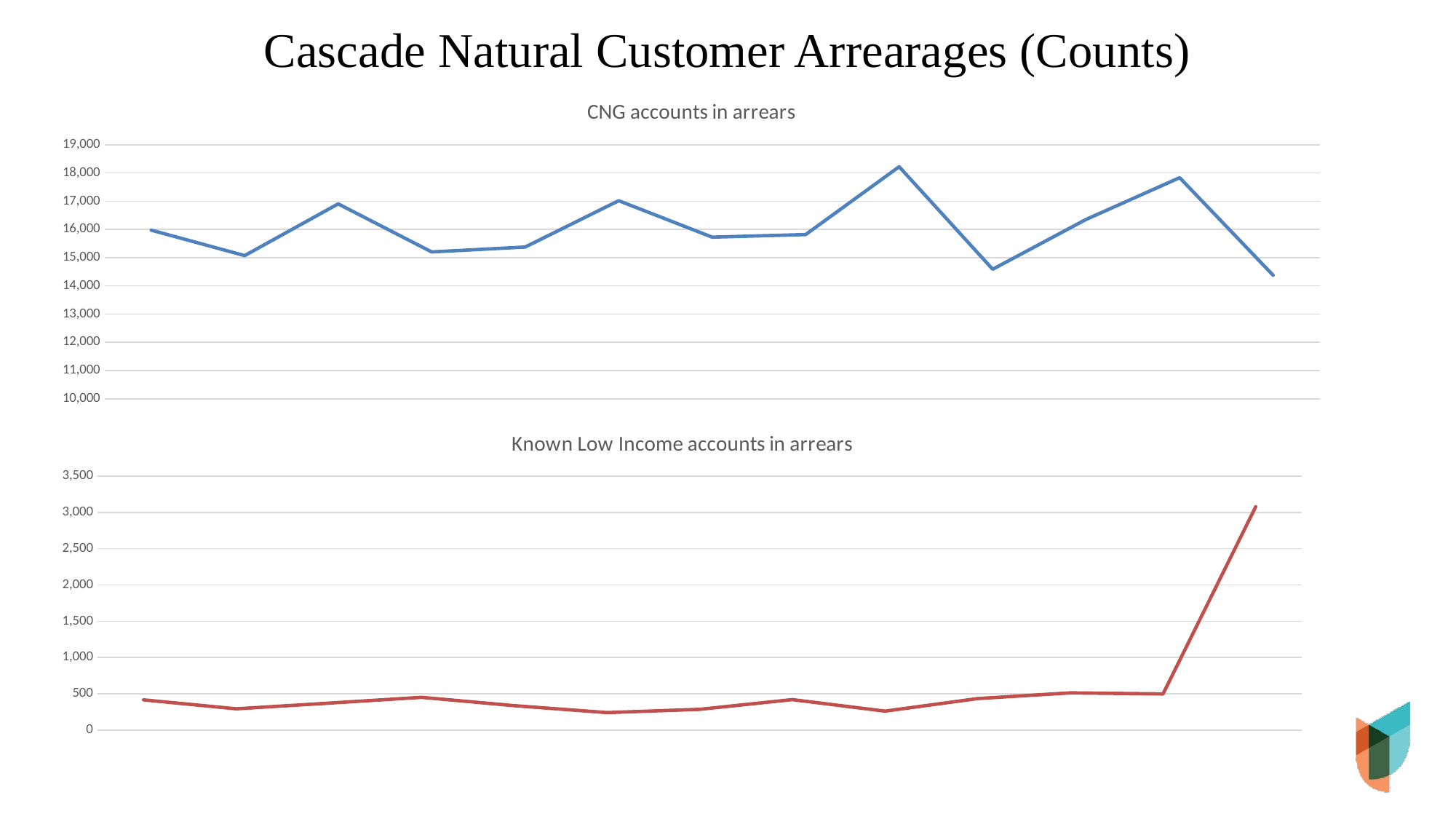
How many charts are shown on the slide? 2 On the "CNG accounts in arrears" chart, is the highest point on the line greater or less than 18,000? greater On the "Known Low Income accounts in arrears" chart, is the last point on the line greater or less than 3,000? greater How many data points are plotted on the "CNG accounts in arrears" line? 13 What is the title of the top chart on the slide? CNG accounts in arrears How many data points are plotted on the "Known Low Income accounts in arrears" line? 13 On the "Known Low Income accounts in arrears" chart, does the line rise or fall between the second-to-last and last points? rise On the "Known Low Income accounts in arrears" chart, is the first point on the line greater or less than 500? less What kind of chart is the "CNG accounts in arrears" chart? line chart What kind of chart is the "Known Low Income accounts in arrears" chart? line chart What colour is the line on the "Known Low Income accounts in arrears" chart? red